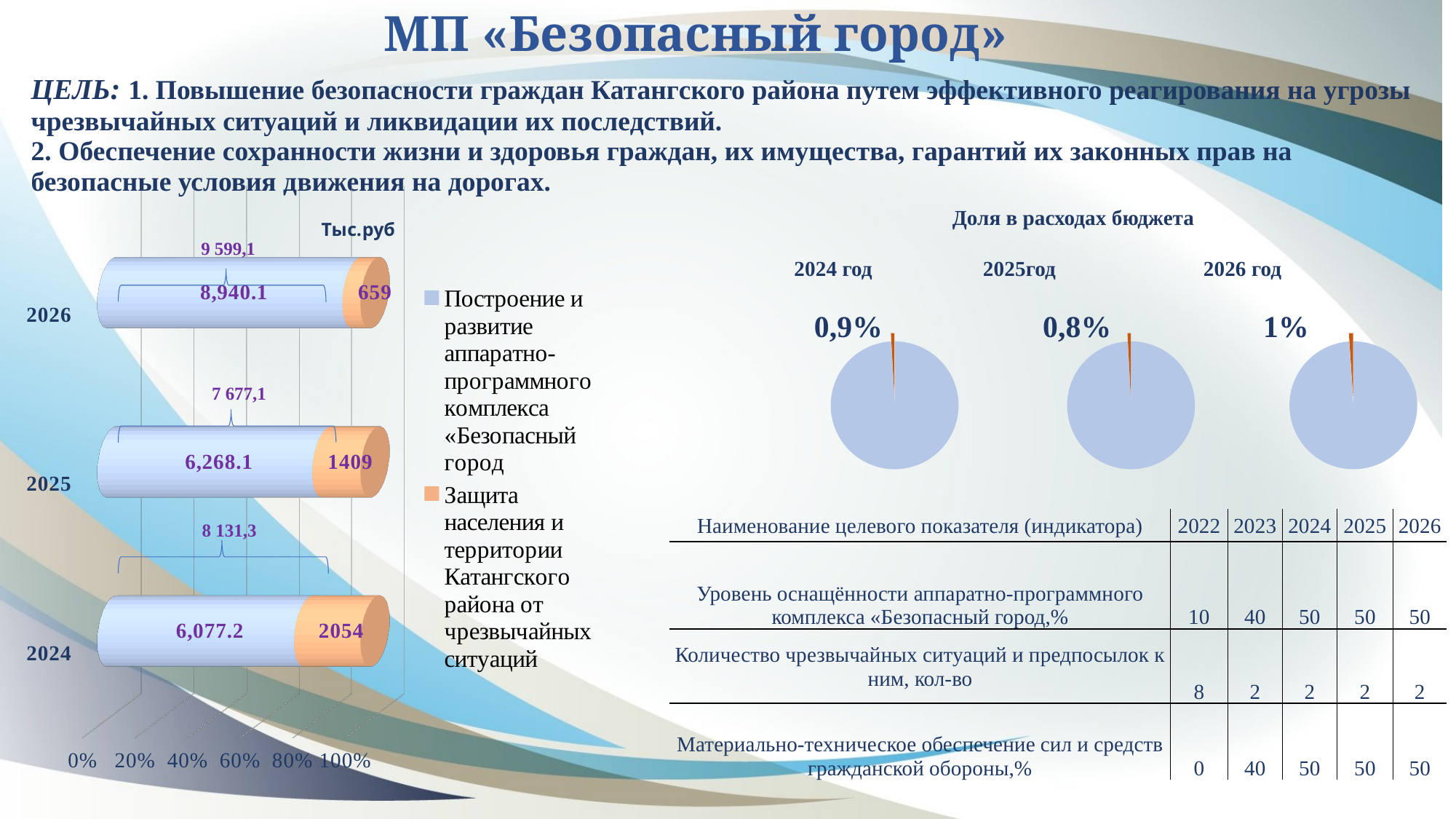
On the bar chart on the left, what is the value for 'Защита населения и территории Катангского района от чрезвычайных ситуаций' in 2025? 1409 What kind of chart is used on the left side of the slide to show the budget amounts in тыс.руб? Bar chart On the bar chart on the left, which year has the lowest value for 'Построение и развитие аппаратно-программного комплекса «Безопасный город'? 2024 On the bar chart on the left, which year has the highest value for 'Защита населения и территории Катангского района от чрезвычайных ситуаций'? 2024 On the bar chart on the left, what is the value for 'Защита населения и территории Катангского района от чрезвычайных ситуаций' in 2024? 2054 On the bar chart on the left, how many years are shown? 3 On the bar chart on the left, what total is shown above the 2026 bar? 9 599,1 On the bar chart on the left, what is the value for 'Построение и развитие аппаратно-программного комплекса «Безопасный город' in 2026? 8,940.1 On the bar chart on the left, what total is shown above the 2025 bar? 7 677,1 In the 'Доля в расходах бюджета' pie charts, what share is shown for 2025 год? 0,8% On the bar chart on the left, how many series does the legend list? 2 On the bar chart on the left, what is the difference between the 'Защита населения' values for 2024 and 2025? 645